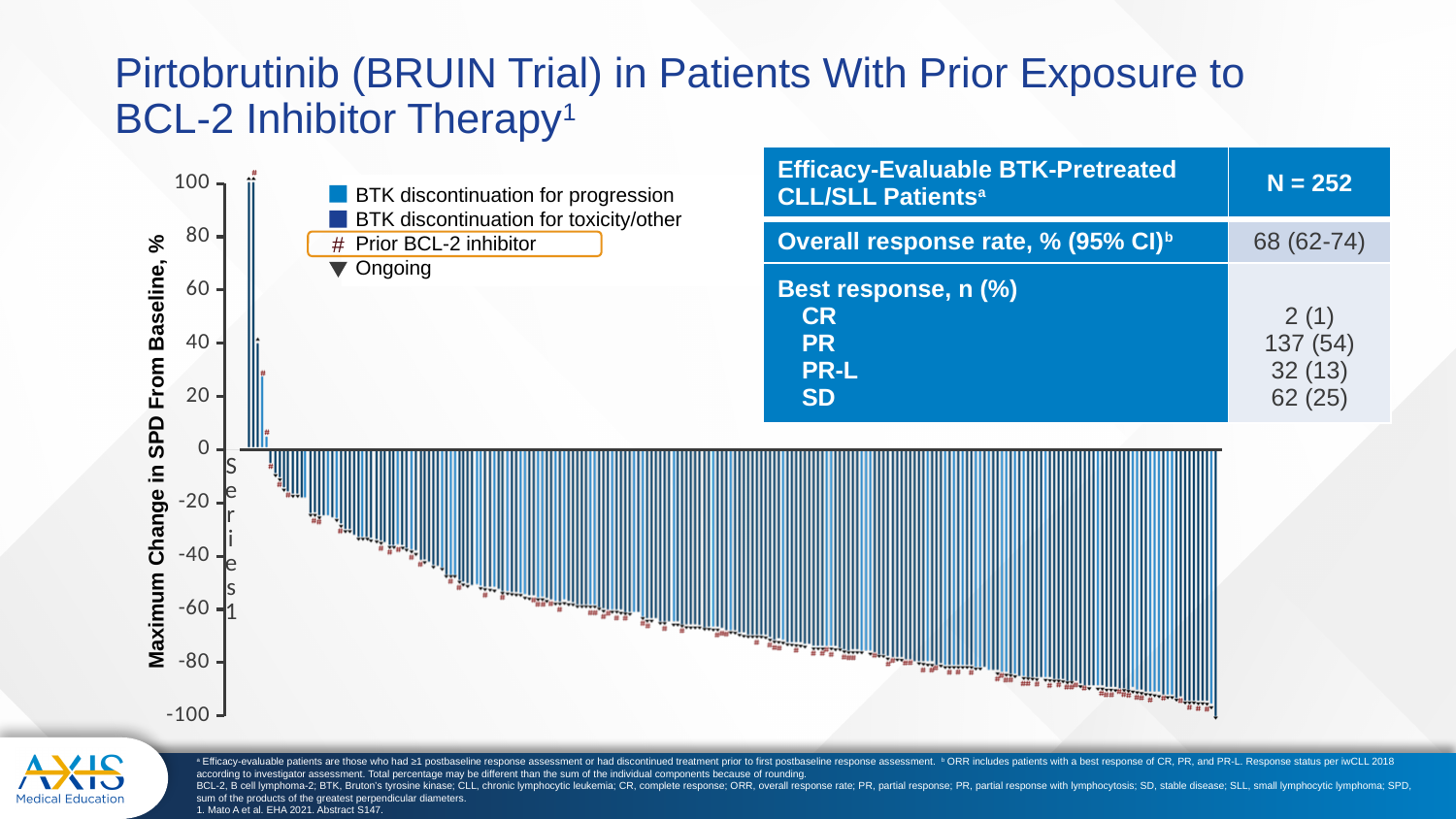
Which legend entry is marked with the # symbol? Prior BCL-2 inhibitor What kind of chart is shown on the slide? bar chart Are most of the bars in the chart above or below 0? below Do the bar values rise or fall moving from left to right along the x axis? fall How many entries does the chart's legend list? 4 What is the interval between consecutive tick marks on the y-axis? 20 Is the value of the tallest bar on the left of the chart greater or less than 80? greater What is the lowest value shown on the y-axis? -100 Is the value of the rightmost bar greater or less than -80? less What is the label of the y-axis of the chart? Maximum Change in SPD From Baseline, % What is the highest value shown on the y-axis? 100